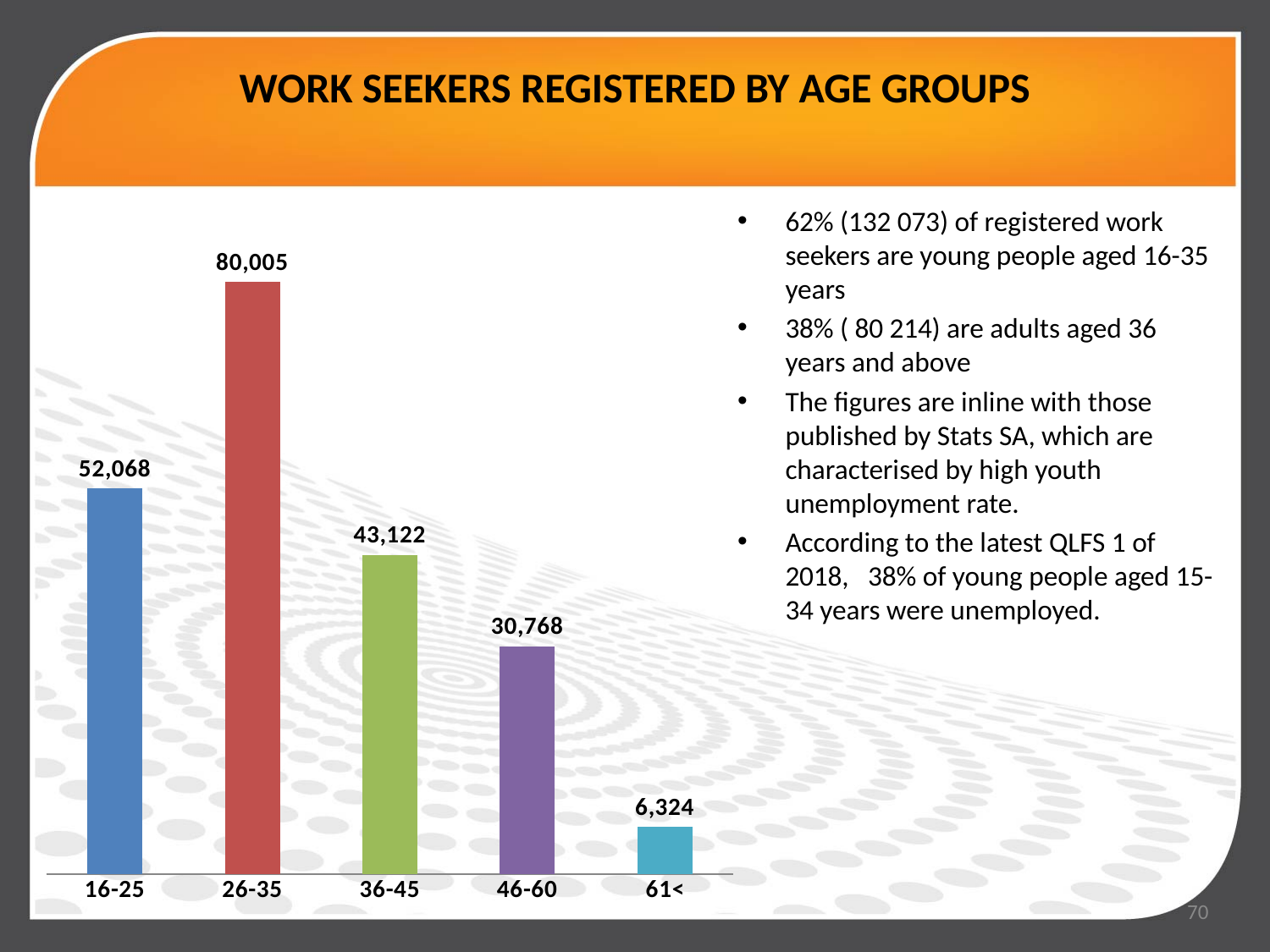
Which age group has more registered work seekers, 36-45 or 46-60? 36-45 What is the title of the slide containing the chart? WORK SEEKERS REGISTERED BY AGE GROUPS Which age group has the lowest number of registered work seekers? 61< What type of chart is shown on the slide? Bar chart What is the number of registered work seekers in the 26-35 age group? 80,005 What is the difference between the values for the 36-45 and 46-60 age groups? 12,354 What is the difference between the values for the 26-35 and 16-25 age groups? 27,937 Which age group has the highest number of registered work seekers? 26-35 What is the number of registered work seekers in the 16-25 age group? 52,068 What is the value shown for the 61< age group? 6,324 How many age groups are shown in the chart? 5 What is the value shown for the 46-60 age group? 30,768